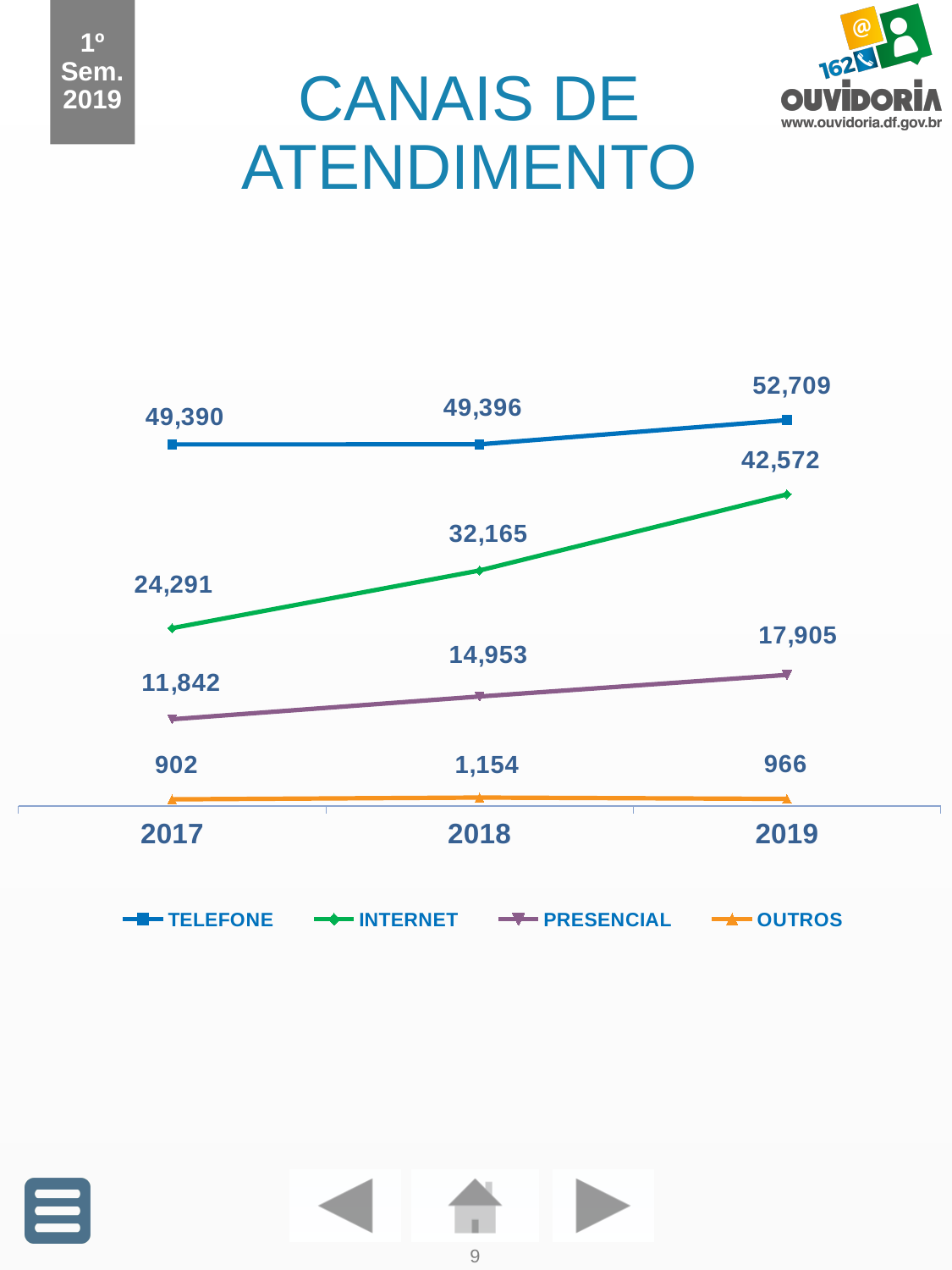
What is the value for PRESENCIAL in 2018? 14,953 What is the value for OUTROS in 2018? 1,154 Which series has the highest value in 2019? TELEFONE What is the value for INTERNET in 2017? 24,291 Does the INTERNET series rise or fall from 2017 to 2019? Rise How many years are shown on the x axis? 3 Which is larger: the PRESENCIAL value in 2019 or the INTERNET value in 2017? INTERNET value in 2017 What is the value for TELEFONE in 2019? 52,709 What is the difference between the INTERNET values for 2019 and 2017? 18,281 Which series has the lowest value in 2017? OUTROS How many series does the legend list? 4 What kind of chart is shown on the slide? Line chart